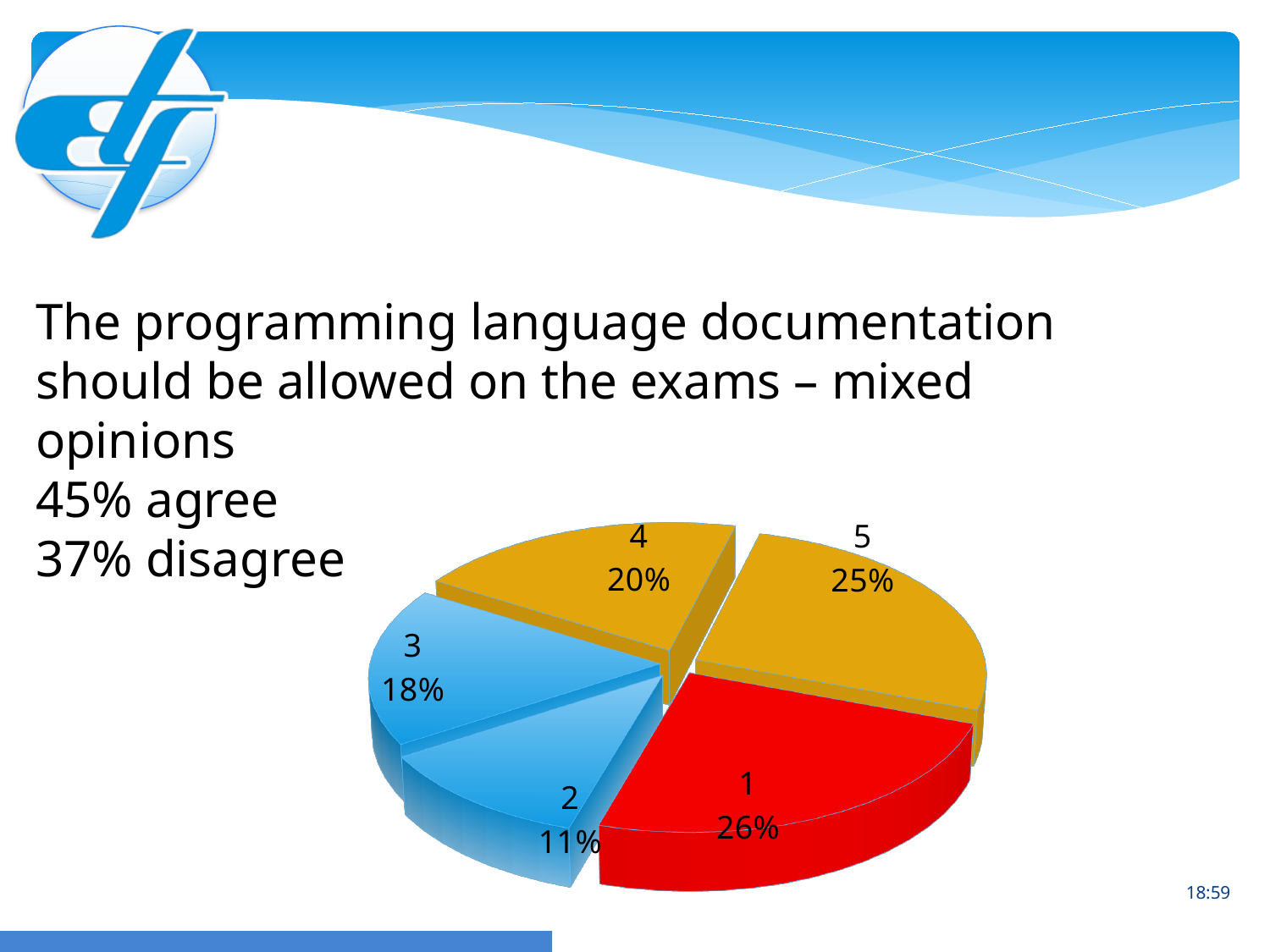
What percentage is shown for slice 4? 20% What colour is slice 1 in the pie chart? red Which slice has the smallest share of the pie? 2 How many slices does the pie chart have? 5 Which slice is larger, slice 4 or slice 2? 4 What percentage is shown for slice 2? 11% What percentage is shown for slice 1? 26% What is the difference in percentage points between slice 5 and slice 3? 7 What kind of chart is shown on the slide? pie chart What percentage is shown for slice 5? 25% What percentage is shown for slice 3? 18% Which slice has the largest share of the pie? 1